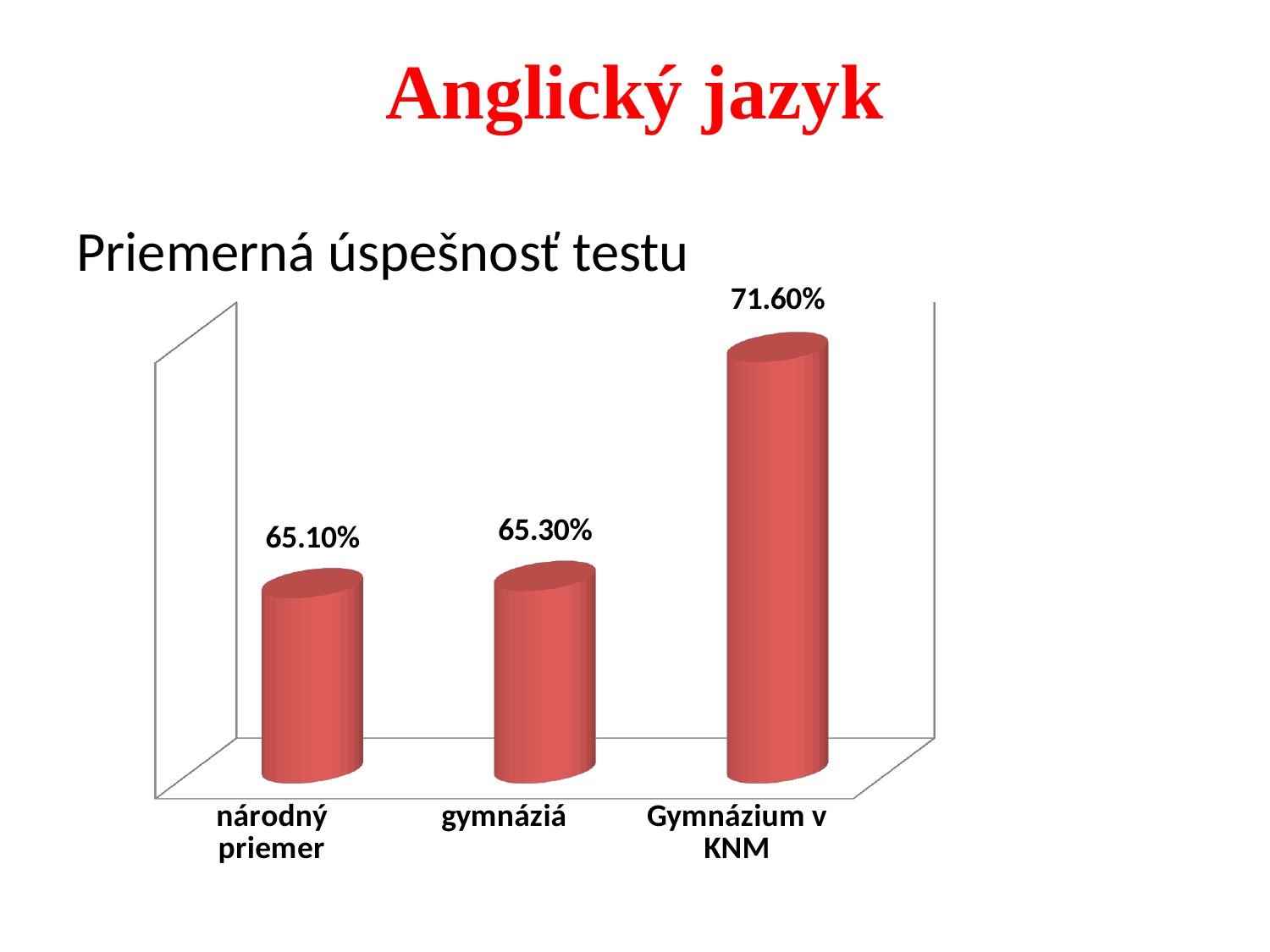
What is the difference between the values for gymnáziá and národný priemer? 0.20% What is the value for Gymnázium v KNM? 71.60% What is the difference between the values for Gymnázium v KNM and národný priemer? 6.50% Which category has the highest value? Gymnázium v KNM What is the value for gymnáziá? 65.30% Do the values rise or fall from left to right across the categories? rise How many categories are shown in the chart? 3 What is the difference between the values for Gymnázium v KNM and gymnáziá? 6.30% Which is larger, the value for Gymnázium v KNM or the value for gymnáziá? Gymnázium v KNM What is the title of the chart? Priemerná úspešnosť testu What kind of chart is shown on the slide? bar chart What is the value for národný priemer? 65.10%